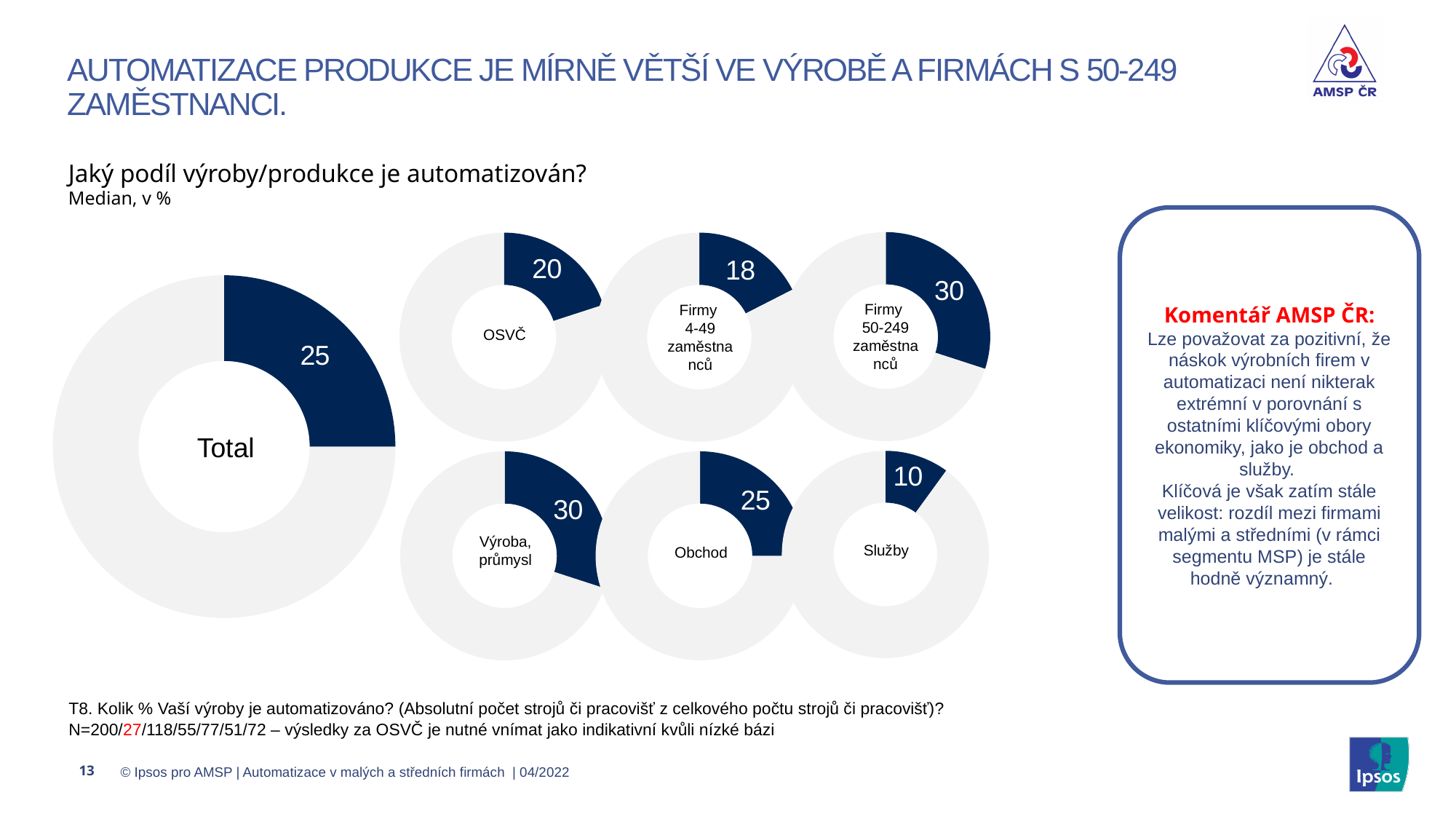
What is the difference between the value in the Firmy 50-249 zaměstnanců donut chart and the value in the Firmy 4-49 zaměstnanců donut chart? 12 Across the donut charts on the slide, which segment has the lowest value? Služby What is the difference between the value in the Výroba, průmysl donut chart and the value in the Služby donut chart? 20 In the Služby donut chart, what value is shown? 10 In the Firmy 4-49 zaměstnanců donut chart, what value is shown? 18 In the Firmy 50-249 zaměstnanců donut chart, what value is shown? 30 Comparing the Firmy 4-49 zaměstnanců and Firmy 50-249 zaměstnanců donut charts, which shows the larger value? Firmy 50-249 zaměstnanců In the Total donut chart, what value is shown? 25 How many donut charts are shown on the slide? 7 What type of chart is used to show the Total value on the slide? Donut chart In the Obchod donut chart, what value is shown? 25 In the OSVČ donut chart, what value is shown? 20